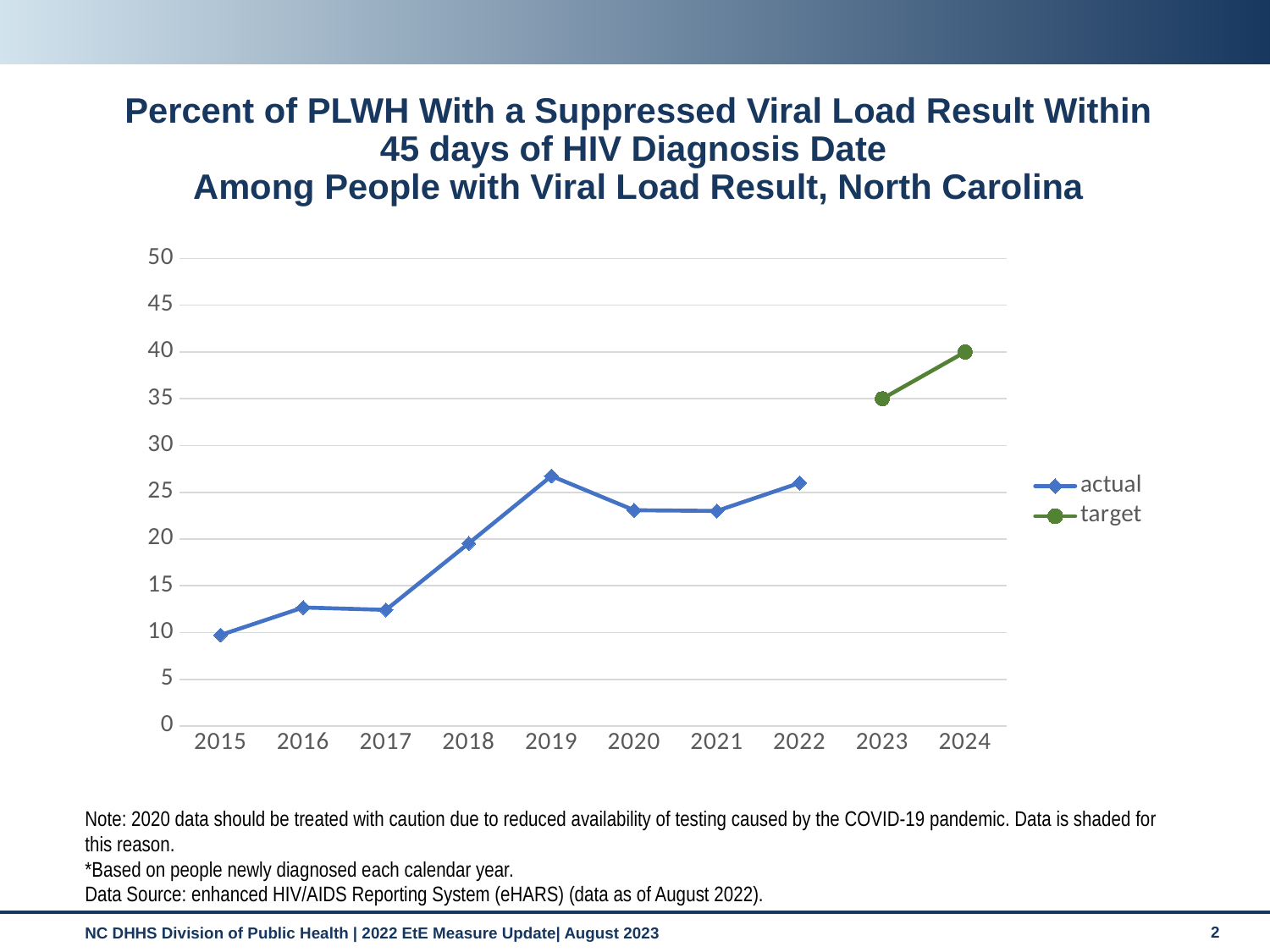
What is the target value for 2023? 35 Which year has the lowest actual value? 2015 What kind of chart is shown on the slide? line chart Is the actual value for 2017 greater or less than 15? less Do the actual values rise or fall from 2015 to 2019? rise What are the two series named in the legend? actual and target How many series does the legend list? 2 What is the difference between the 2024 target and the 2023 target? 5 Is the actual value for 2019 greater or less than 25? greater How many years are shown on the x axis? 10 What is the target value for 2024? 40 Is the actual value for 2020 greater or less than 25? less